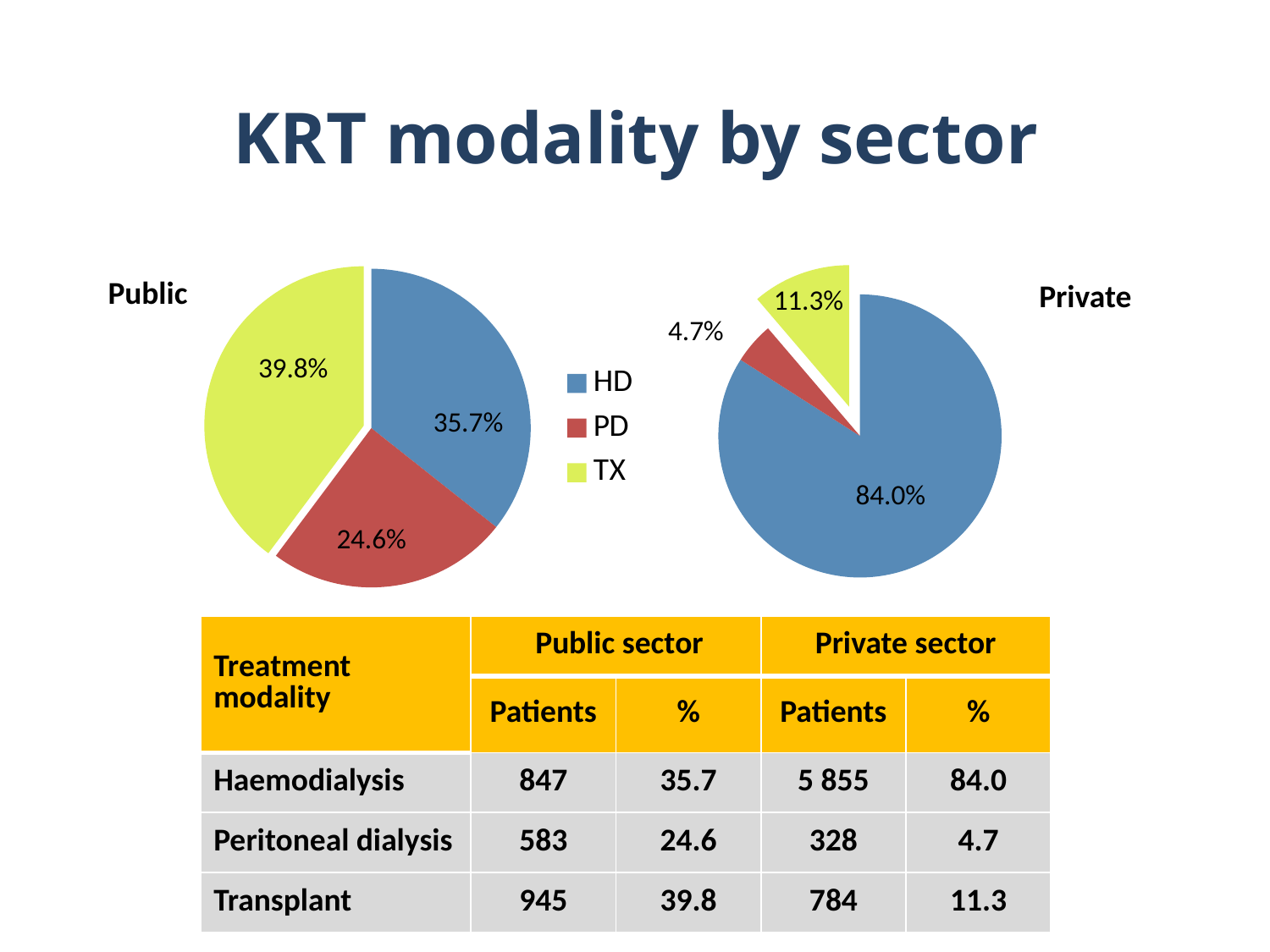
In the Public pie chart, what is the difference between the TX share and the PD share? 15.2% In the Public pie chart, which modality has the smallest slice? PD In the Private pie chart, what share does HD have? 84.0% In the Public pie chart, what share does TX have? 39.8% In the Public pie chart, what share does HD have? 35.7% In the Private pie chart, what is the difference between the HD share and the TX share? 72.7% What type of chart is used to show the Private sector modalities? Pie chart Which is larger: the HD share in the Public pie chart or the HD share in the Private pie chart? Private In the Private pie chart, what share does PD have? 4.7% In the Private pie chart, which modality has the smallest slice? PD How many slices does the Public pie chart have? 3 In the Public pie chart, which modality has the largest slice? TX